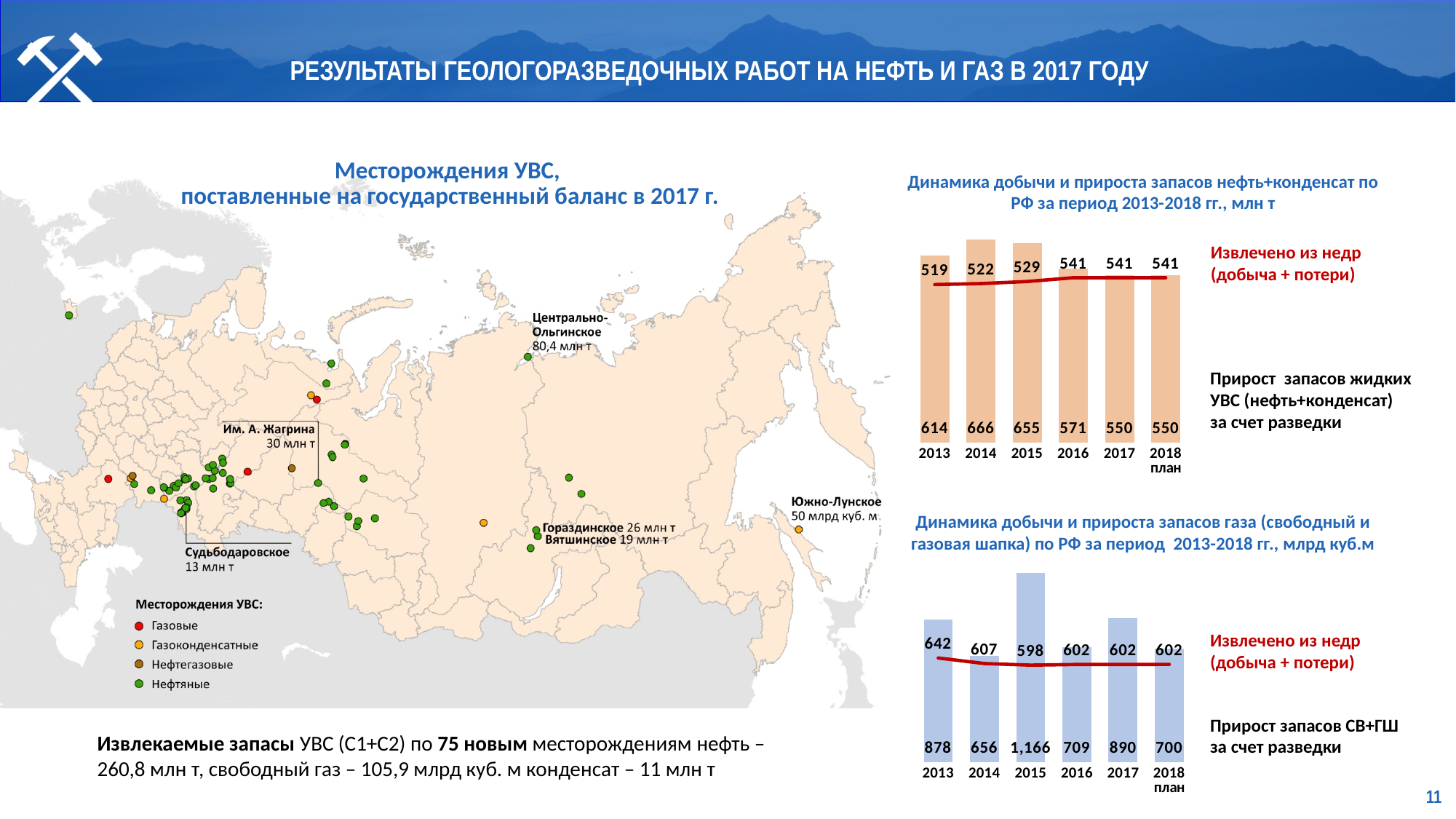
In the top chart (oil+condensate), does the extracted volume rise or fall from 2013 to 2016? rise In the bottom chart (gas), which year has the lowest reserve growth from exploration? 2014 What kind of chart is the top chart (oil+condensate)? bar chart with a line In the top chart (oil+condensate), what is the reserve growth from exploration in 2014? 666 In the top chart (oil+condensate), what is the extracted volume (production + losses) in 2013? 519 In the bottom chart (gas), what is the extracted volume (production + losses) in 2013? 642 How many years are shown on the x axis of the bottom chart (gas)? 6 In the top chart (oil+condensate), what is the difference between reserve growth in 2014 and in 2017? 116 In the top chart (oil+condensate), which year has the highest reserve growth from exploration? 2014 In the bottom chart (gas), what is the difference between extracted volume in 2013 and in 2014? 35 In the bottom chart (gas), what is the reserve growth from exploration in 2015? 1,166 In the bottom chart (gas), which is larger: reserve growth in 2017 or in 2016? 2017